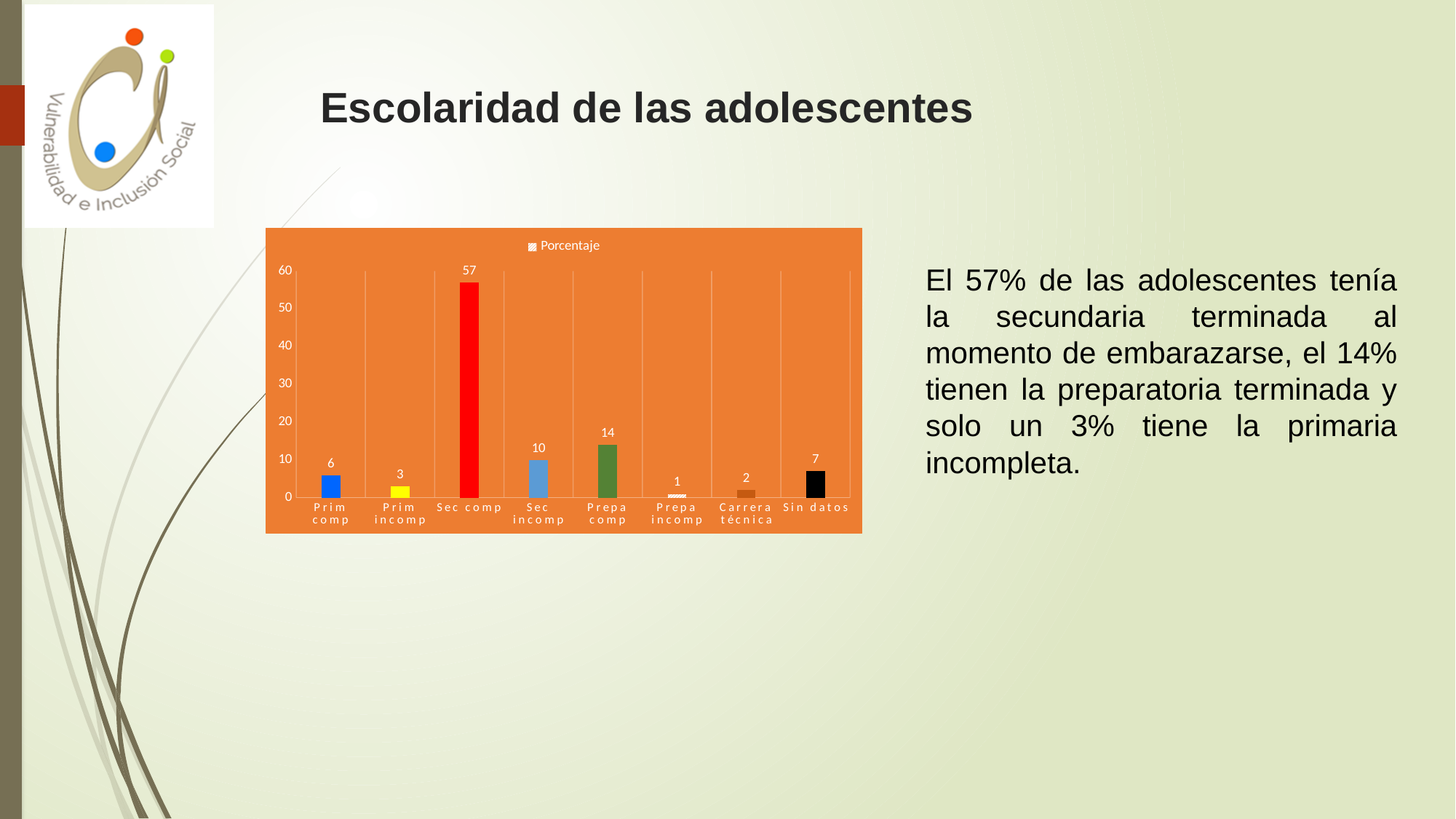
How many series does the legend list? 1 What kind of chart is shown on the slide? bar chart What is the name of the series shown in the legend? Porcentaje What is the value for Carrera técnica? 2 What is the value for Prepa comp? 14 How many categories are shown on the x axis? 8 What is the value for Sin datos? 7 Which category has the lowest value? Prepa incomp Which category has the highest value? Sec comp Which is larger, the value for Sec incomp or the value for Prim comp? Sec incomp What is the difference between the values for Sec comp and Prepa comp? 43 What is the value for Sec comp? 57